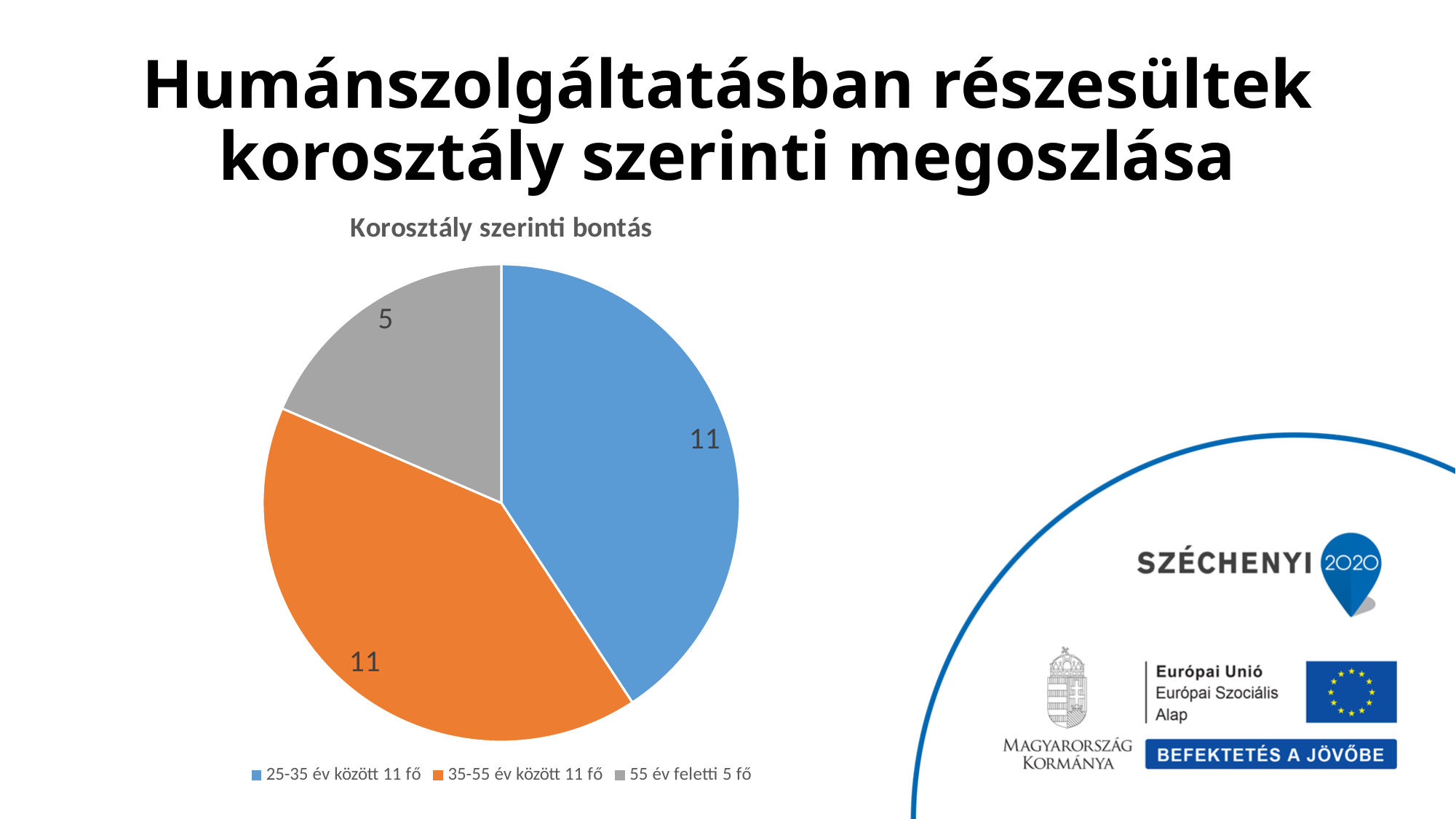
What is the difference between the 35-55 év között value and the 55 év feletti value? 6 What is the total of all slices in the pie chart? 27 What is the title of the chart? Korosztály szerinti bontás How many slices does the pie chart have? 3 Which colour represents the 55 év feletti category in the legend? grey What is the value for the 25-35 év között slice? 11 Are the 25-35 év között and 35-55 év között slices equal in value? yes, both are 11 What is the value for the 35-55 év között slice? 11 Which category has the smallest slice? 55 év feletti What is the value for the 55 év feletti slice? 5 Which is larger, the 25-35 év között slice or the 55 év feletti slice? 25-35 év között What type of chart is shown on the slide? pie chart